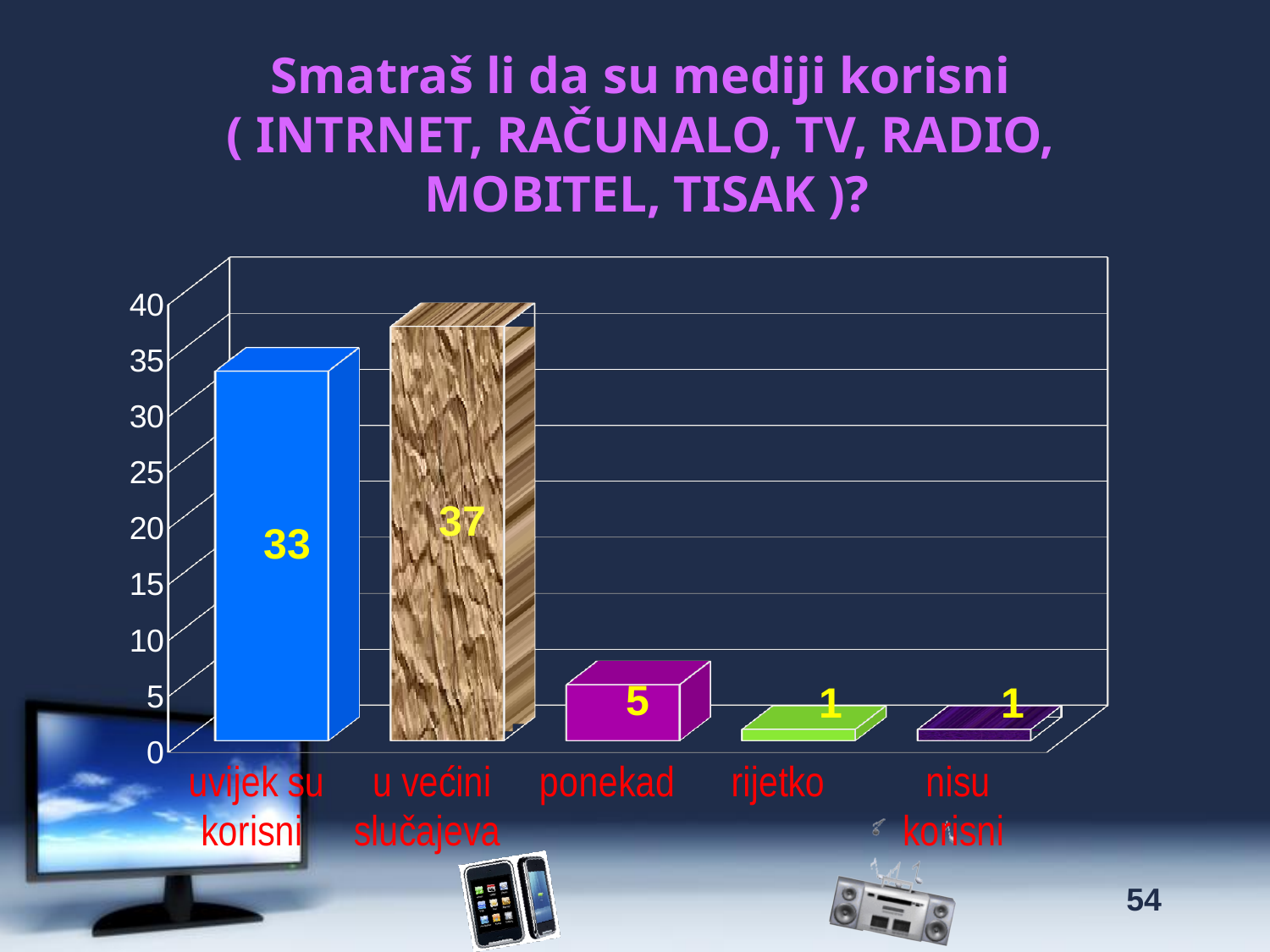
What value is shown for "ponekad"? 5 What value is shown for "uvijek su korisni"? 33 Is the value for "uvijek su korisni" greater or less than 30? greater What is the title of the chart? Smatraš li da su mediji korisni ( INTRNET, RAČUNALO, TV, RADIO, MOBITEL, TISAK )? What value is shown for "u većini slučajeva"? 37 Which is larger, the value for "ponekad" or the value for "nisu korisni"? ponekad How many categories are shown on the x axis? 5 What value is shown for "rijetko"? 1 What kind of chart is shown on the slide? bar chart What is the difference between the values for "uvijek su korisni" and "ponekad"? 28 Which category has the highest value? u većini slučajeva What is the difference between the values for "u većini slučajeva" and "uvijek su korisni"? 4